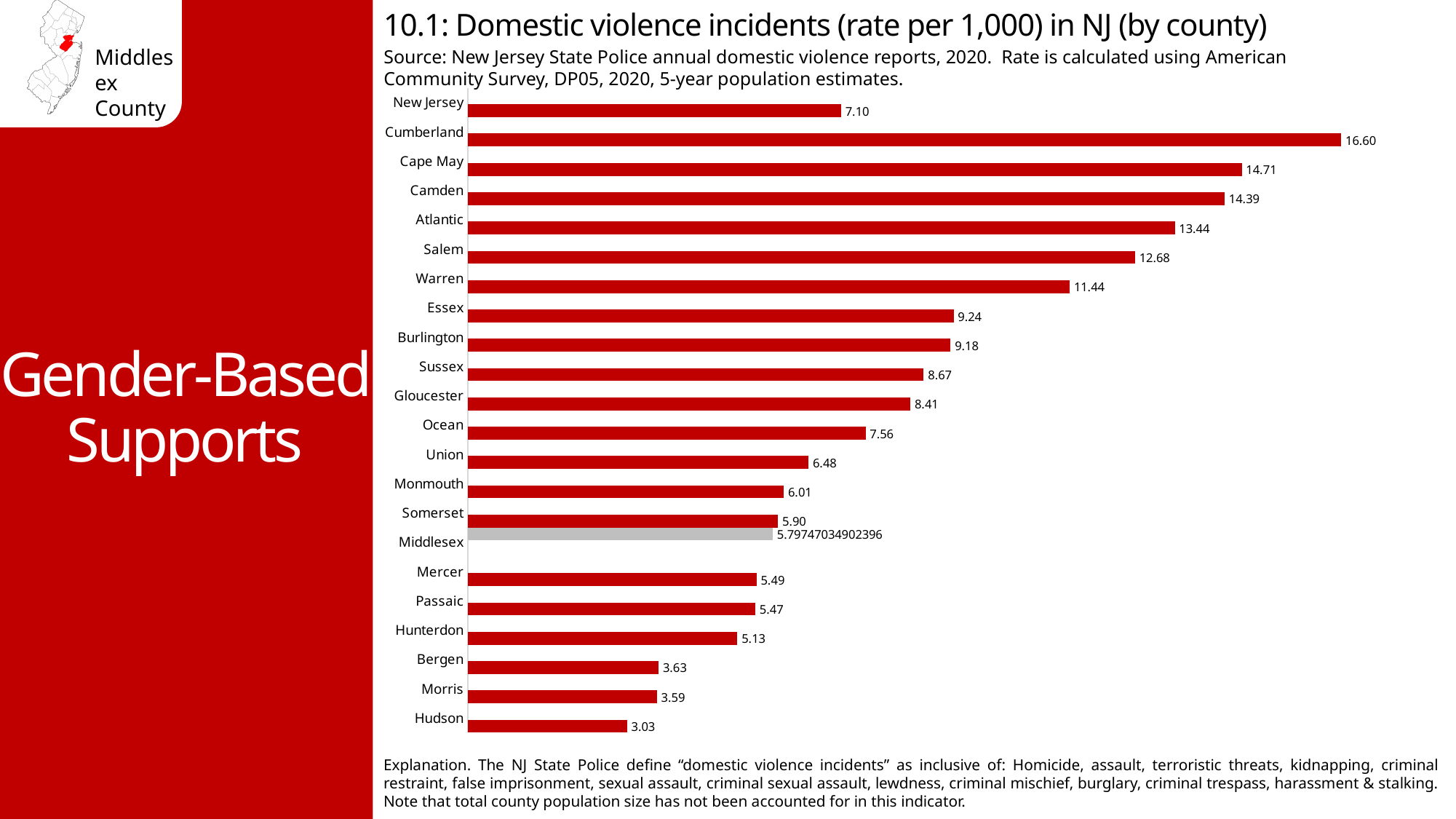
Which bar is shown in a different colour (grey) from the others? Middlesex Which county has the lowest domestic violence incident rate? Hudson What value is labeled on the Middlesex bar? 5.79747034902396 What type of chart is used on this slide? Bar chart What is the difference between the rates for Cumberland and Hudson? 13.57 What is the domestic violence incident rate per 1,000 for Cumberland? 16.60 Which has a higher rate, Warren or Salem? Salem What is the difference between the rates for Ocean and New Jersey? 0.46 What is the domestic violence incident rate per 1,000 shown for New Jersey overall? 7.10 How many bars (categories) are shown in the chart? 22 Which has a higher rate, Essex or Burlington? Essex Which county has the highest domestic violence incident rate? Cumberland